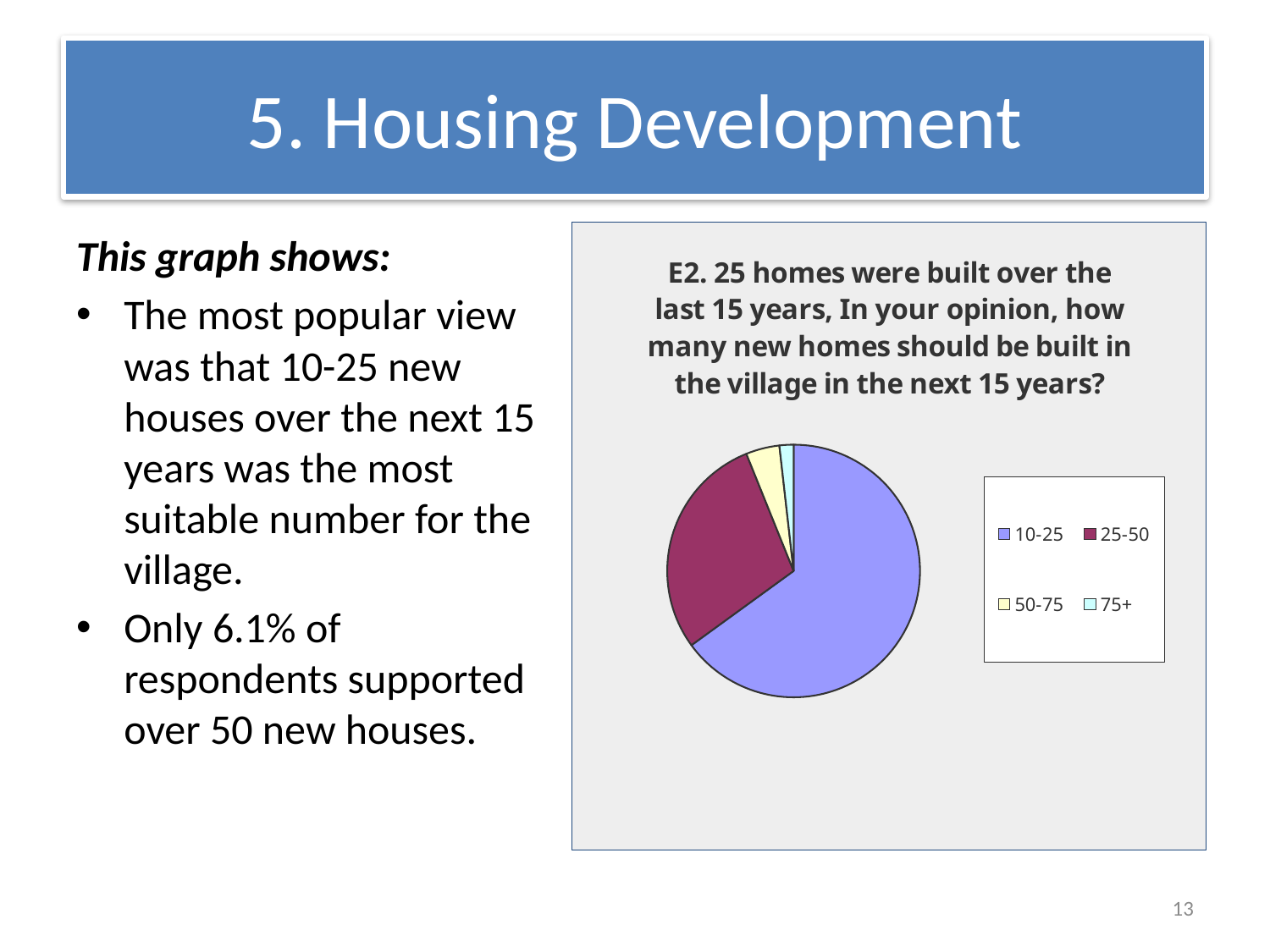
Which category has the second-largest slice of the pie chart? 25-50 Which category has the largest slice of the pie chart? 10-25 What are the four categories listed in the chart's legend? 10-25, 25-50, 50-75, 75+ Which slice is larger, 25-50 or 50-75? 25-50 Which slice is larger, 25-50 or 75+? 25-50 Which category has the smallest slice of the pie chart? 75+ How many categories does the pie chart show? 4 Which slice is larger, 10-25 or 25-50? 10-25 What is the title of the pie chart? E2. 25 homes were built over the last 15 years, In your opinion, how many new homes should be built in the village in the next 15 years? What kind of chart is shown on the slide? pie chart